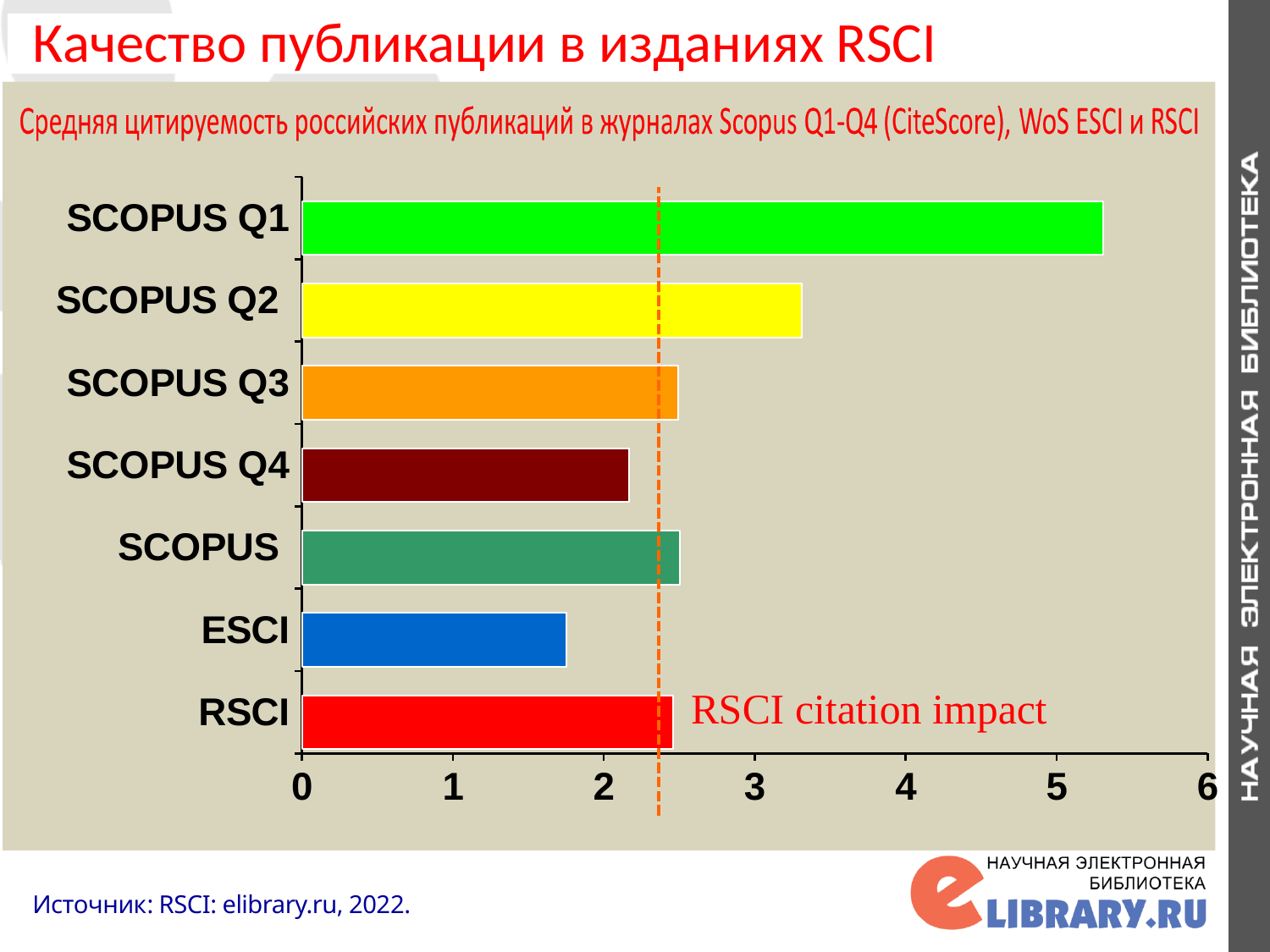
Which is larger, the value for SCOPUS Q2 or the value for SCOPUS Q4? SCOPUS Q2 Is the value for SCOPUS Q4 greater or less than 2? greater Is the value for SCOPUS Q2 greater or less than 3? greater Is the value for SCOPUS Q1 greater or less than 5? greater What kind of chart is shown on the slide? bar chart Which is larger, the value for RSCI or the value for ESCI? RSCI What label is written next to the dashed vertical line in the chart? RSCI citation impact How many categories are plotted in the chart? 7 Which category has the lowest average citation value? ESCI Which category has the highest average citation value? SCOPUS Q1